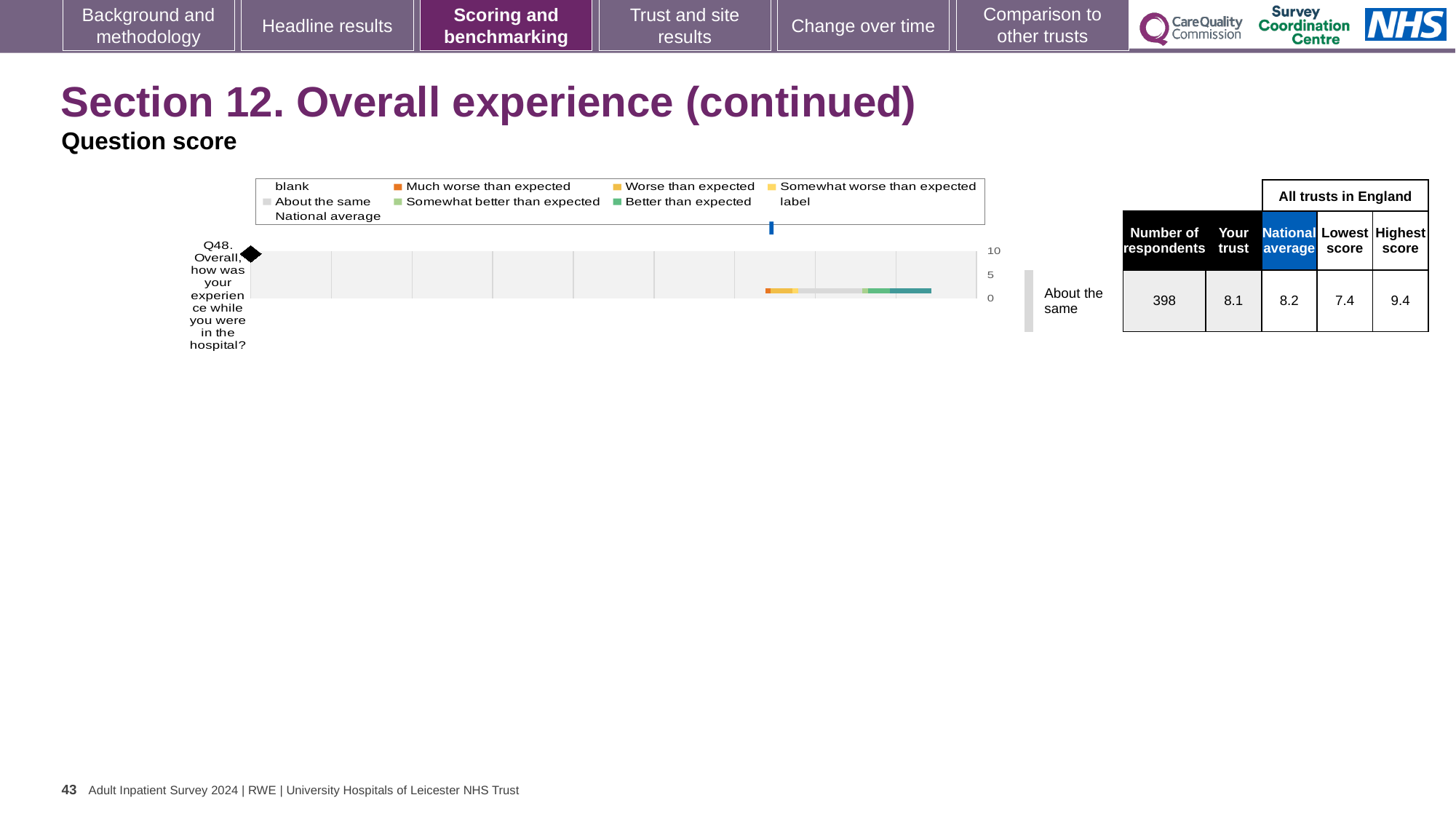
What kind of chart is shown on the slide? bar chart In the table beside the chart, what is the number of respondents for Q48? 398 How many questions (categories) are plotted on the chart? 1 In the table beside the chart, what is the 'Your trust' score for Q48? 8.1 In the table beside the chart, what is the lowest score among all trusts in England for Q48? 7.4 In the table beside the chart, what is the national average score for Q48? 8.2 Which is larger for Q48: the 'Your trust' score or the national average? National average What benchmark category is shown next to the chart for Q48? About the same Which question is plotted on the chart? Q48. Overall, how was your experience while you were in the hospital? What is the highest tick value shown on the chart's value axis? 10 In the table beside the chart, what is the highest score among all trusts in England for Q48? 9.4 What is the difference between the highest score and the lowest score for Q48 in the table? 2.0